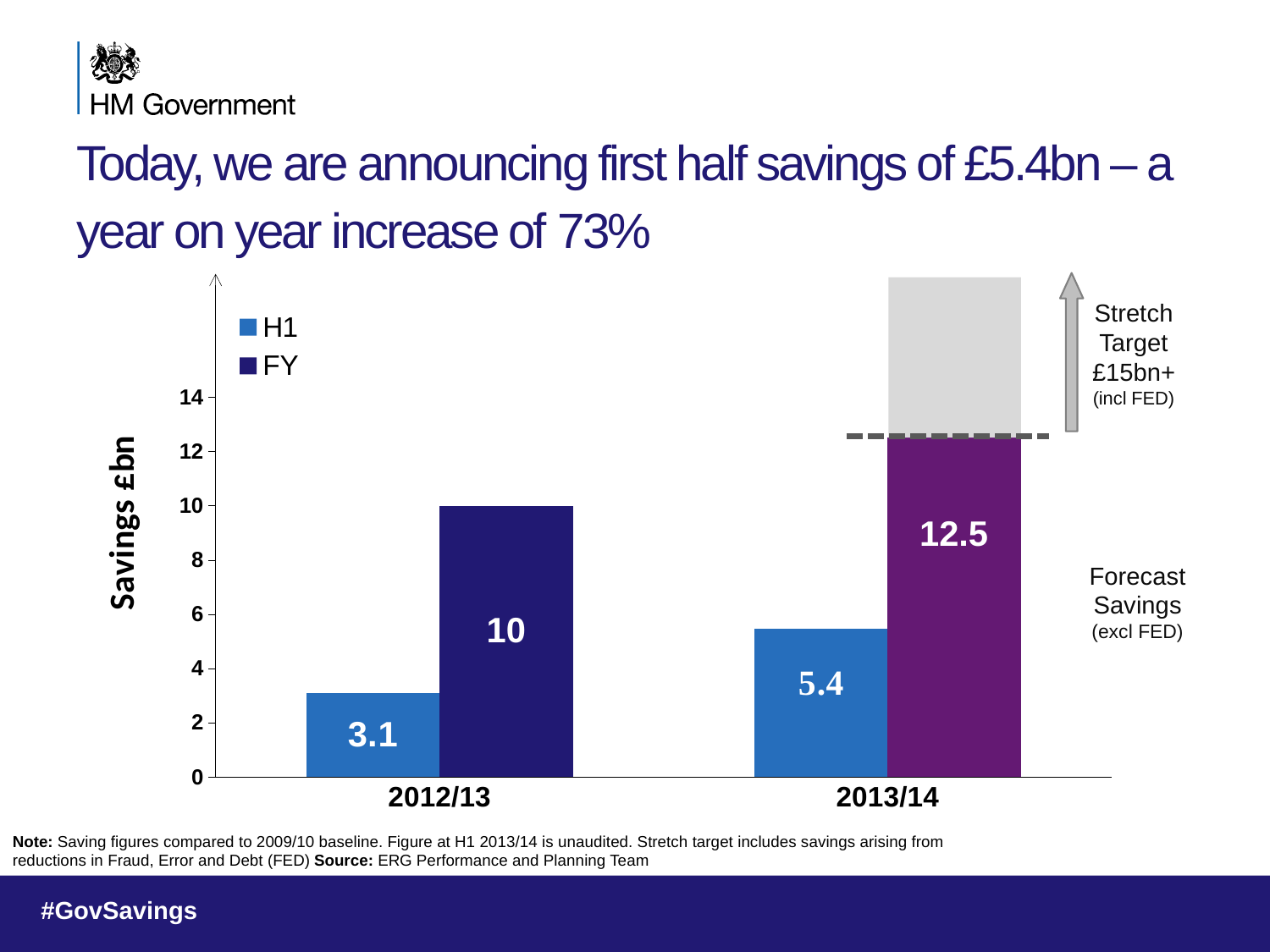
What is the difference between the H1 savings for 2013/14 and 2012/13? 2.3 What is the FY savings value for 2013/14? 12.5 What is the difference between the FY savings for 2013/14 and 2012/13? 2.5 What kind of chart is shown on the slide? bar chart What is the FY savings value for 2012/13? 10 Is the FY value for 2012/13 larger or smaller than the FY value for 2013/14? smaller How many series does the legend list? 2 What is the label of the y axis? Savings £bn Which year has the higher H1 savings value? 2013/14 What is the H1 savings value for 2012/13? 3.1 How many year categories are shown on the x axis? 2 What is the H1 savings value for 2013/14? 5.4